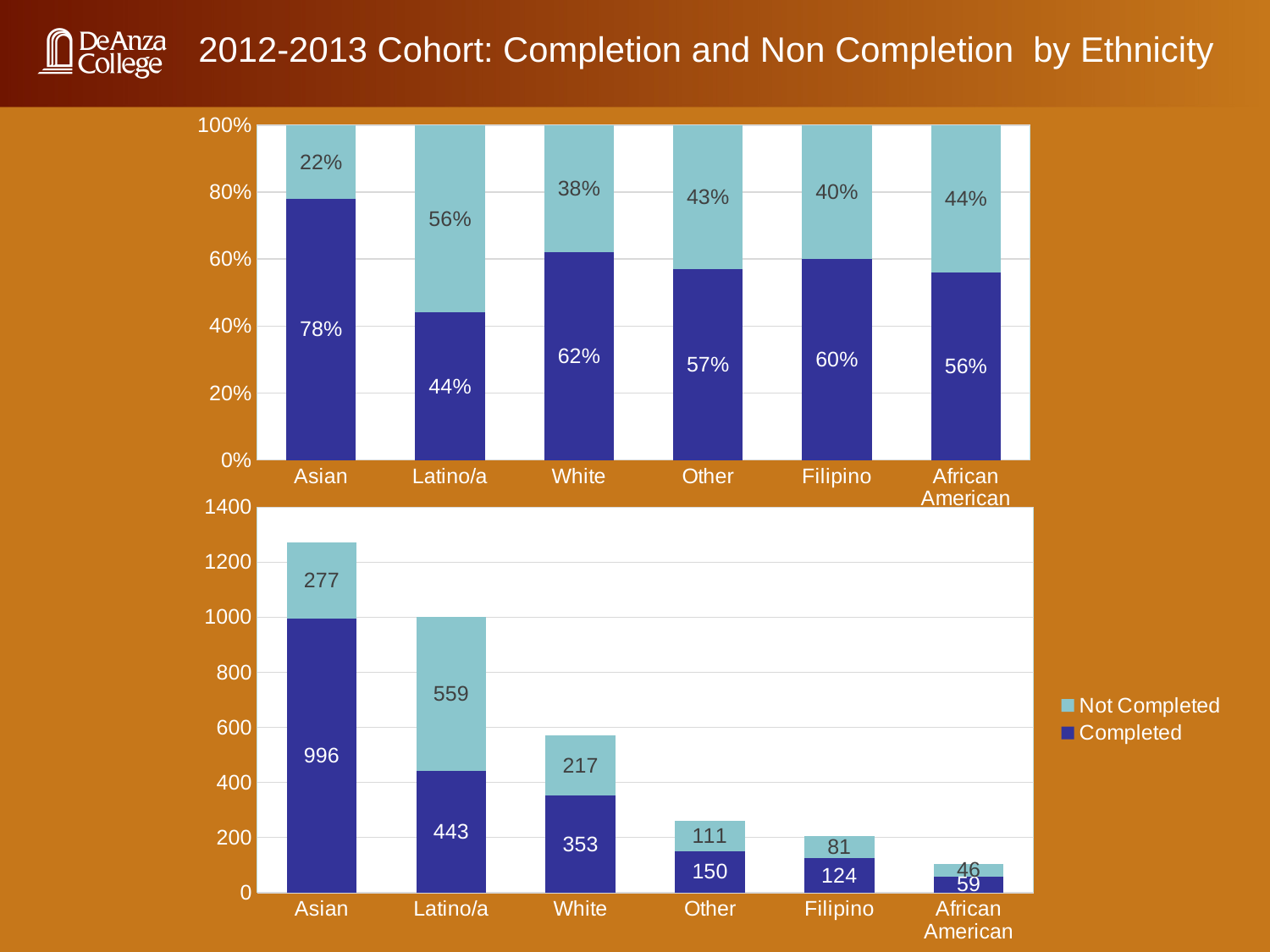
In the bottom chart (counts), what is the total of the Asian bar (Completed plus Not Completed)? 1273 In the top chart (percentages), which ethnicity has the highest Completed percentage? Asian In the bottom chart (counts), which ethnicity has the lowest Completed count? African American In the bottom chart (counts), what is the Completed count for White? 353 In the bottom chart (counts), which is larger, the Not Completed count for Other or the Not Completed count for African American? Other In the top chart (percentages), what is the Completed percentage for Asian? 78% In the bottom chart (counts), what is the difference between the Completed counts for Asian and Latino/a? 553 In the top chart (percentages), what is the Not Completed percentage for Latino/a? 56% How many ethnicity categories are shown in the bottom chart? 6 How many series does the legend list? 2 In the top chart (percentages), which ethnicity has the lowest Completed percentage? Latino/a In the bottom chart (counts), what is the Not Completed count for Filipino? 81